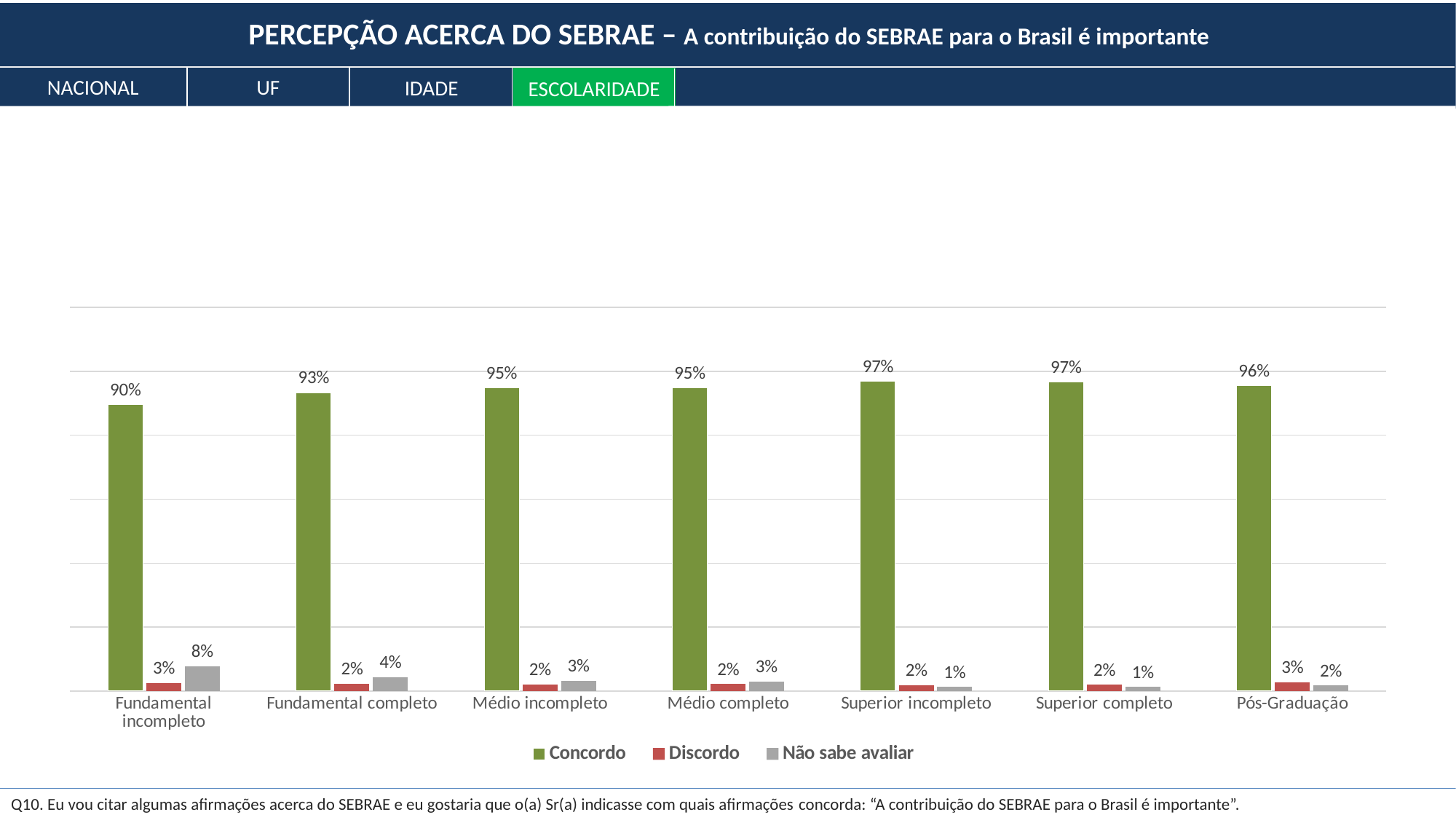
What is the Concordo value for Superior incompleto? 97% What is the Concordo value for Fundamental incompleto? 90% Which category has the highest Não sabe avaliar value? Fundamental incompleto How many education categories are shown on the x axis? 7 Which colour represents the Discordo series in the legend? Red What kind of chart is shown on the slide? Bar chart Which is larger, the Concordo value for Médio completo or for Fundamental completo? Médio completo What is the Discordo value for Pós-Graduação? 3% What is the Não sabe avaliar value for Fundamental completo? 4% What is the difference between the Concordo values for Pós-Graduação and Fundamental incompleto? 6% Which category has the lowest Concordo value? Fundamental incompleto How many series does the legend list? 3